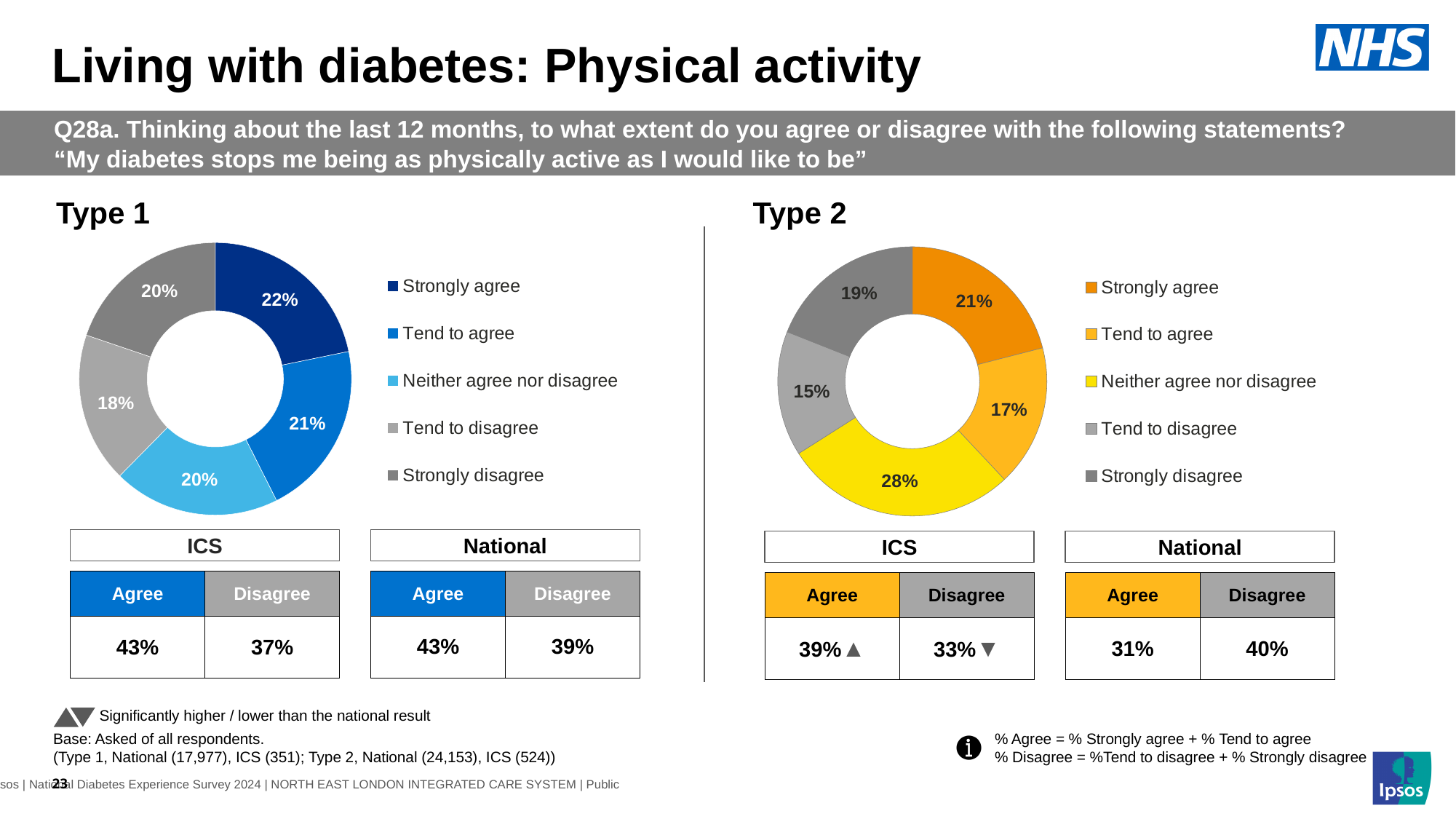
In the Type 2 chart, what colour represents 'Neither agree nor disagree'? Yellow In the Type 1 chart, what percentage of respondents said 'Strongly agree'? 22% In the Type 2 chart, which is larger: 'Strongly agree' or 'Tend to agree'? Strongly agree In the Type 1 chart, what percentage of respondents said 'Tend to disagree'? 18% In the Type 1 chart, which category has the smallest share? Tend to disagree What kind of chart is used for Type 2? Doughnut (pie) chart In the Type 2 chart, which category has the largest share? Neither agree nor disagree In the Type 1 chart, what is the difference between the 'Strongly agree' and 'Tend to disagree' shares? 4 percentage points In the Type 2 chart, what percentage of respondents said 'Neither agree nor disagree'? 28% How many categories does the Type 1 chart show? 5 In the Type 2 chart, which category has the smallest share? Tend to disagree In the Type 2 chart, what percentage of respondents said 'Tend to agree'? 17%